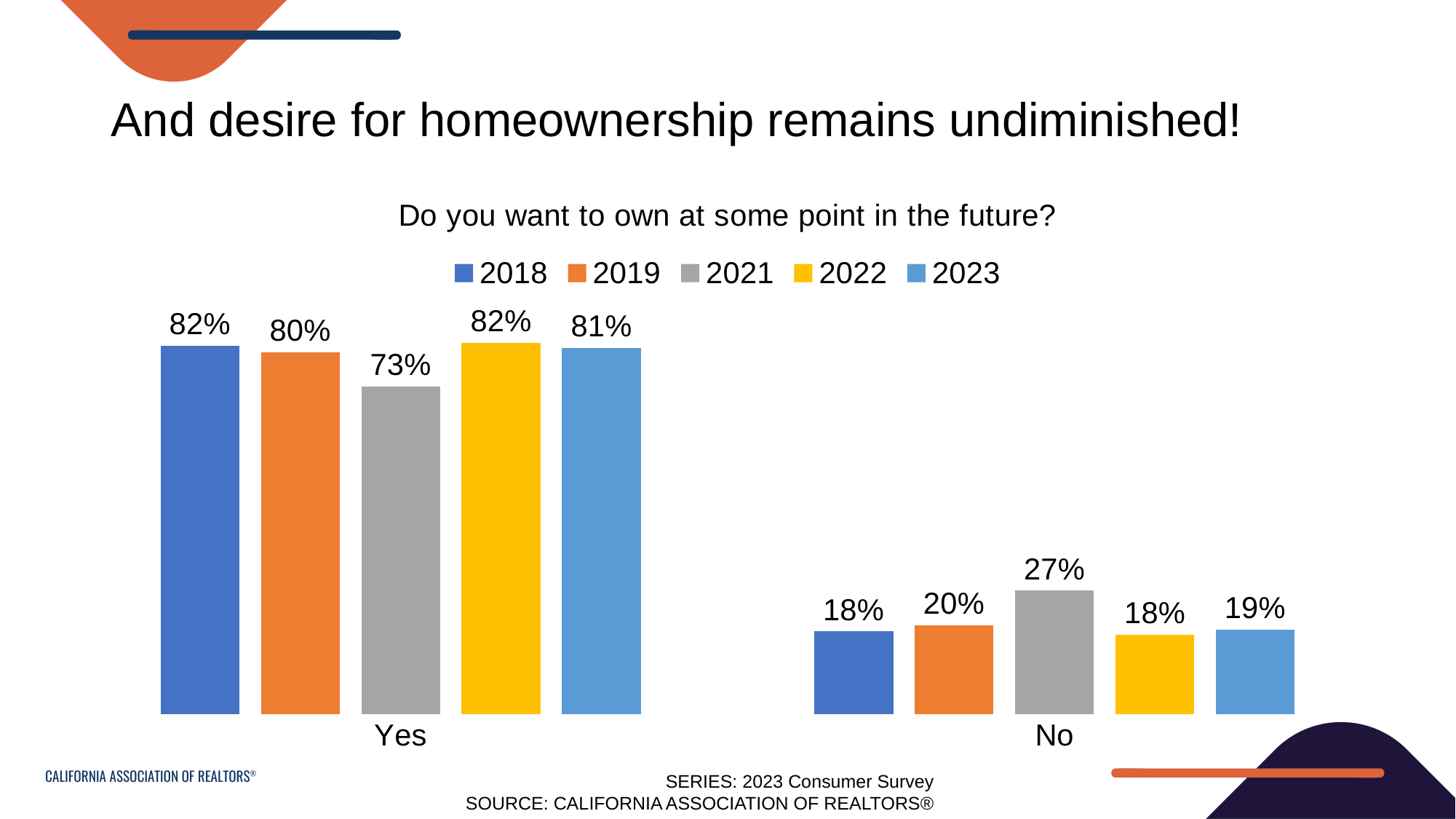
Which year has the highest No value? 2021 What is the difference between the No value in 2021 and the No value in 2023? 8% How many response categories are shown on the x axis? 2 What is the difference between the Yes value in 2018 and the Yes value in 2021? 9% What is the title of the chart? Do you want to own at some point in the future? Which is larger, the No value for 2019 or the No value for 2022? 2019 What percentage answered Yes in 2021? 73% What is the value for Yes in 2023? 81% What percentage answered No in 2019? 20% Which year has the lowest Yes value? 2021 How many series does the legend list? 5 What kind of chart is shown on the slide? Bar chart